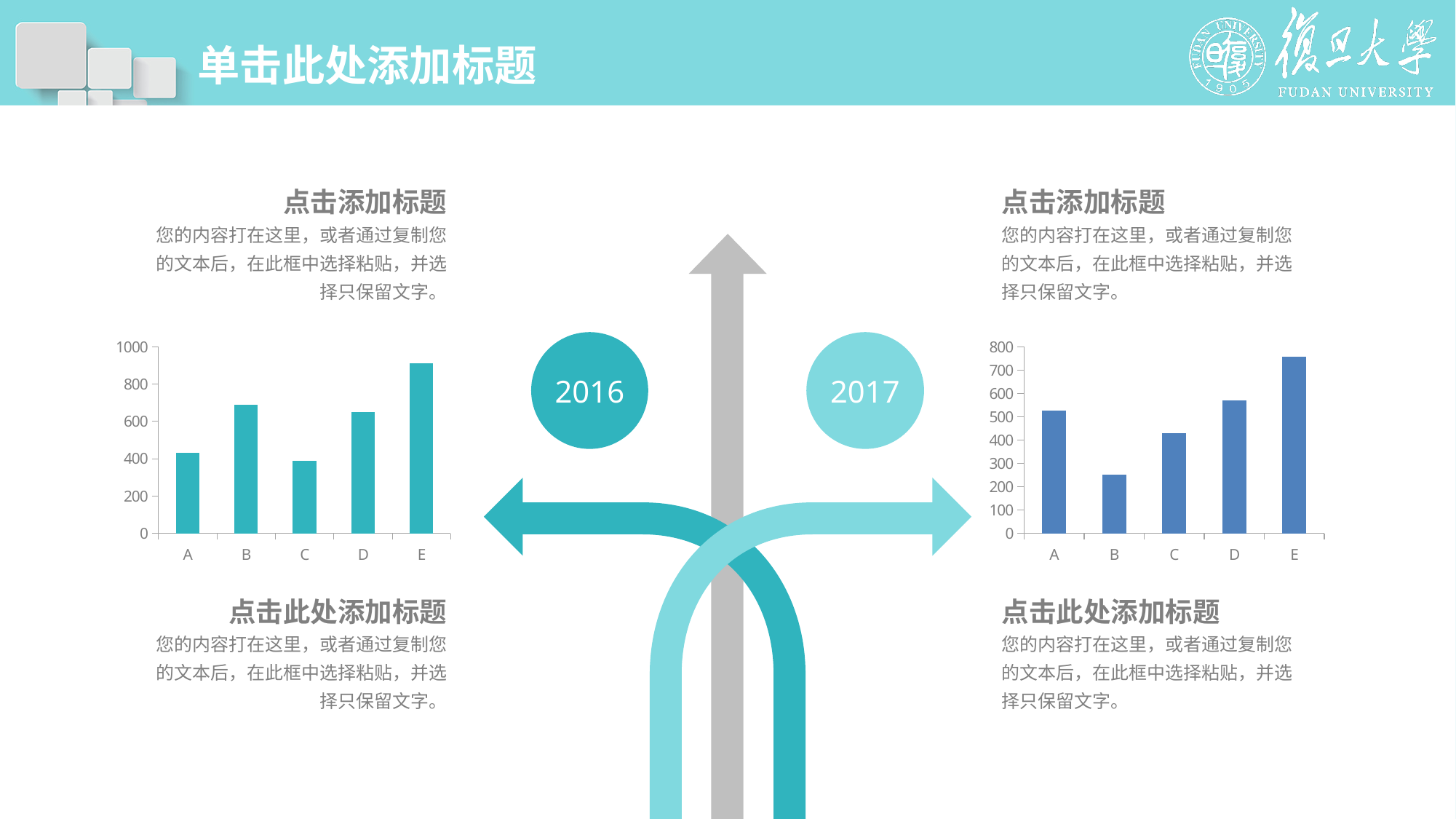
How many categories does the chart on the right side of the slide show? 5 How many categories does the chart on the left side of the slide show? 5 In the chart on the right side of the slide, which category has the highest bar? E In the chart on the left side of the slide, is the value for E greater or less than 800? greater In the chart on the right side of the slide, which category has the lowest bar? B In the chart on the left side of the slide, is the value for A greater or less than 600? less In the chart on the left side of the slide, which is larger, the value for B or the value for D? B What kind of chart is the chart on the left side of the slide? bar chart In the chart on the right side of the slide, is the value for B greater or less than 300? less In the chart on the right side of the slide, which is larger, the value for A or the value for C? A In the chart on the left side of the slide, which category has the highest bar? E In the chart on the left side of the slide, which category has the lowest bar? C